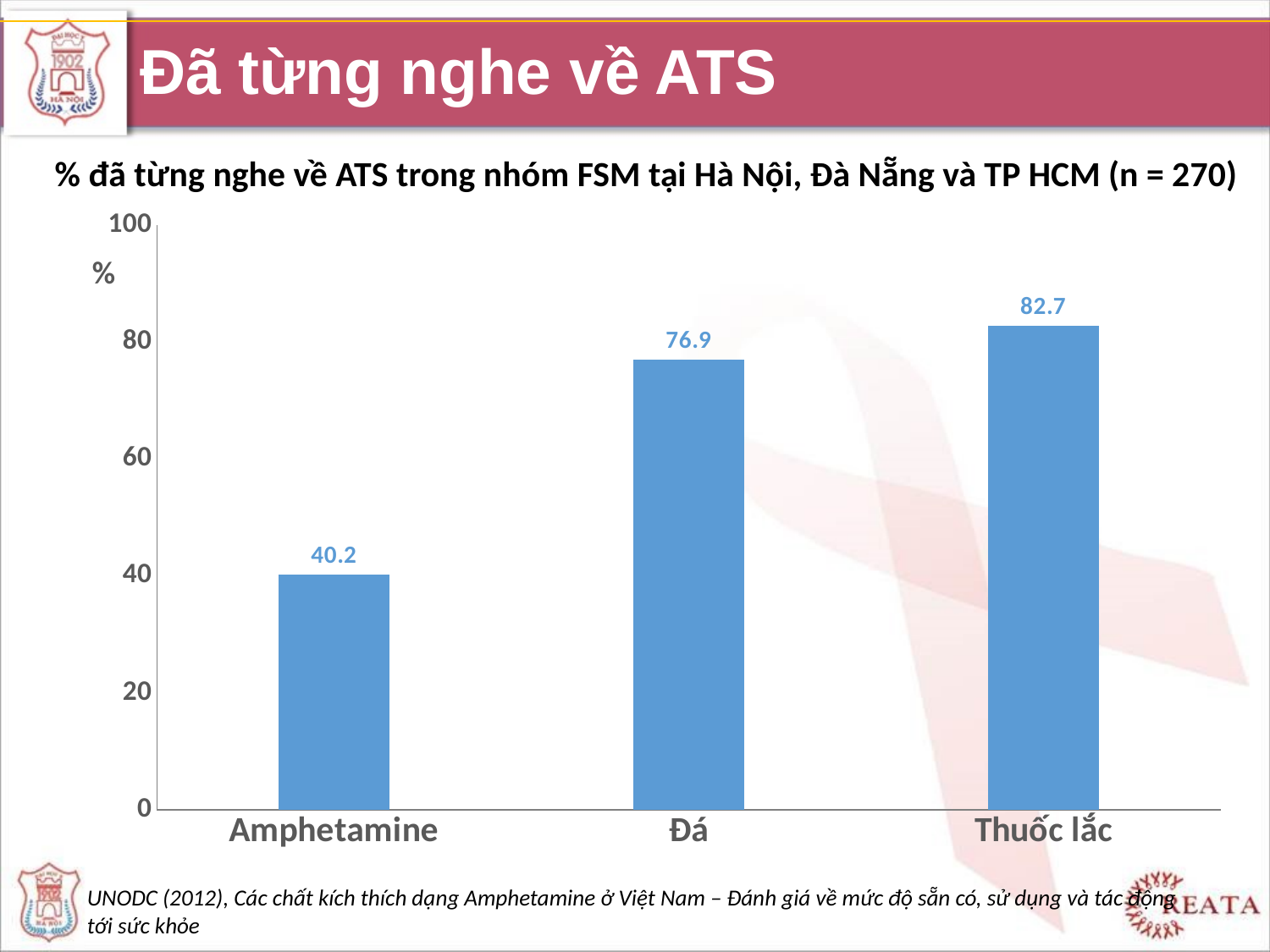
Is the value for Đá greater or less than 60? greater Which is larger, the value for Đá or the value for Amphetamine? Đá How many categories are shown on the x axis? 3 Do the values rise or fall from left to right along the x axis? rise What is the value for Thuốc lắc? 82.7 What is the difference between the values for Thuốc lắc and Amphetamine? 42.5 What is the difference between the values for Đá and Amphetamine? 36.7 Which category has the highest value? Thuốc lắc What kind of chart is shown on the slide? bar chart What is the value for Đá? 76.9 Which category has the lowest value? Amphetamine What is the value for Amphetamine? 40.2